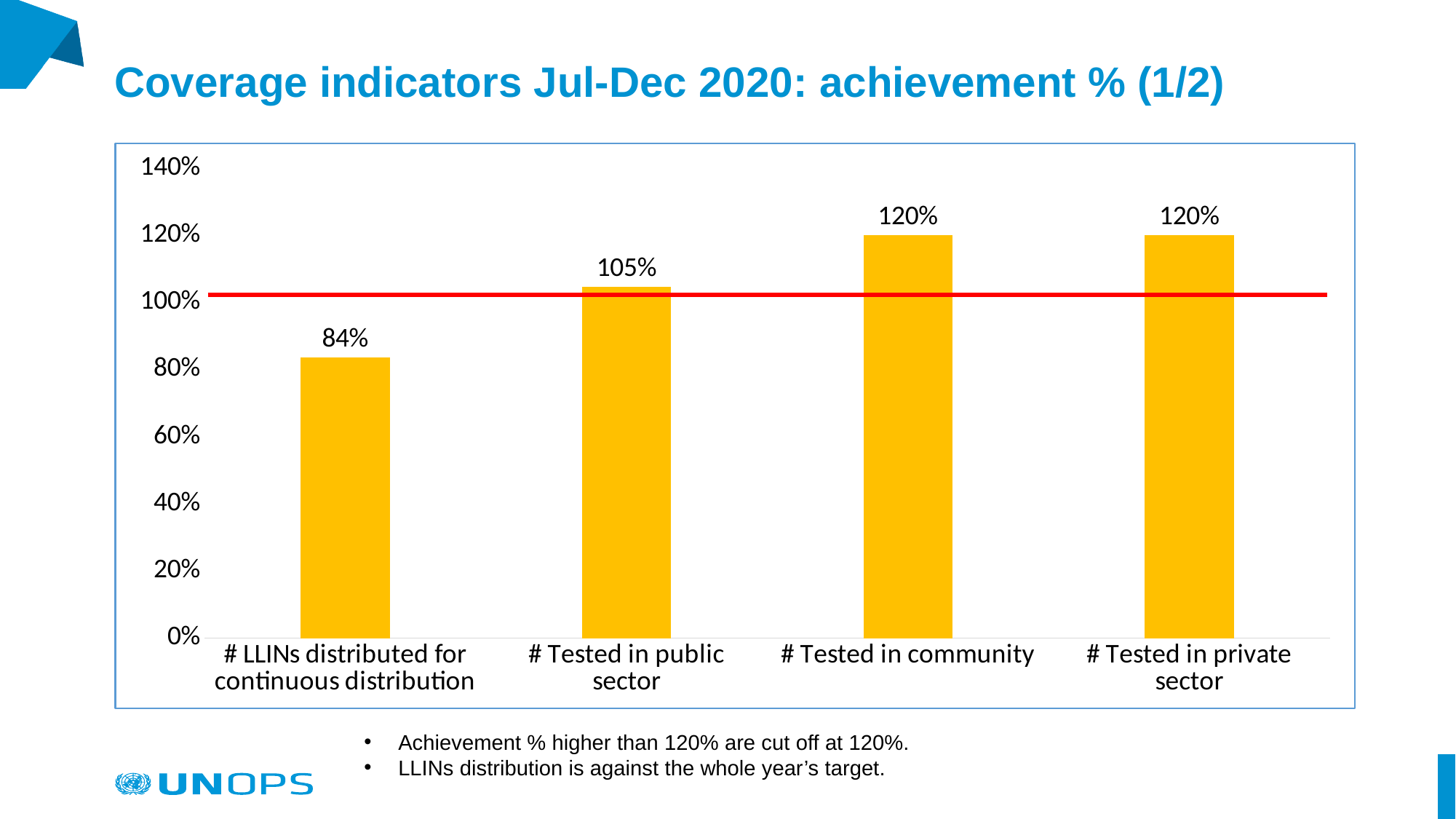
What is the achievement % for # Tested in public sector? 105% How many categories are shown on the chart? 4 At what value is the red horizontal line drawn on the chart? 100% What is the difference between the achievement % for # Tested in community and # LLINs distributed for continuous distribution? 36% What is the achievement % for # Tested in private sector? 120% Which is larger, the achievement % for # Tested in public sector or # Tested in private sector? # Tested in private sector What kind of chart is shown on the slide? bar chart Which category has the lowest achievement %? # LLINs distributed for continuous distribution Is the value for # LLINs distributed for continuous distribution greater or less than 100%? less What is the difference between the achievement % for # Tested in public sector and # LLINs distributed for continuous distribution? 21% What is the achievement % for # LLINs distributed for continuous distribution? 84% What is the achievement % for # Tested in community? 120%